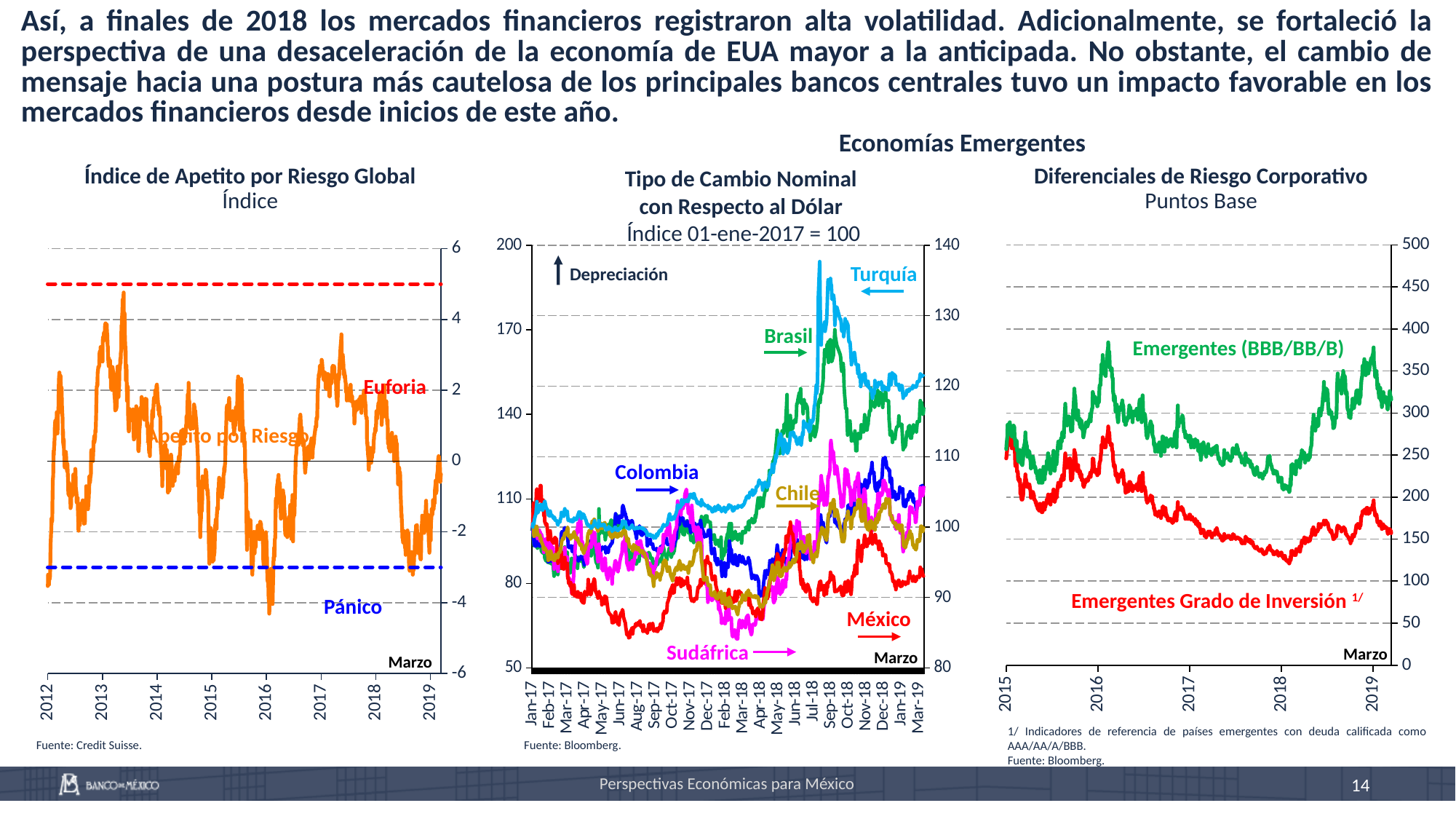
In the 'Índice de Apetito por Riesgo Global' chart, is the peak value reached in 2013 greater or less than 4? greater In the 'Diferenciales de Riesgo Corporativo' chart, does the 'Emergentes Grado de Inversión' series rise or fall between early 2016 and early 2018? fall How many countries are plotted in the 'Tipo de Cambio Nominal con Respecto al Dólar' chart? 6 What is the base of the index in the 'Tipo de Cambio Nominal con Respecto al Dólar' chart? 01-ene-2017 = 100 In the 'Índice de Apetito por Riesgo Global' chart, what label is shown next to the red dashed line? Euforia What kind of chart is the 'Índice de Apetito por Riesgo Global' chart on the left? Line chart In the 'Tipo de Cambio Nominal con Respecto al Dólar' chart, which country is shown in red? México In the 'Diferenciales de Riesgo Corporativo' chart, is the value of 'Emergentes Grado de Inversión' at the end of the series (March 2019) greater or less than 200? less In the 'Índice de Apetito por Riesgo Global' chart, is the lowest value reached in 2016 greater or less than -4? less How many series are plotted in the 'Diferenciales de Riesgo Corporativo' chart? 2